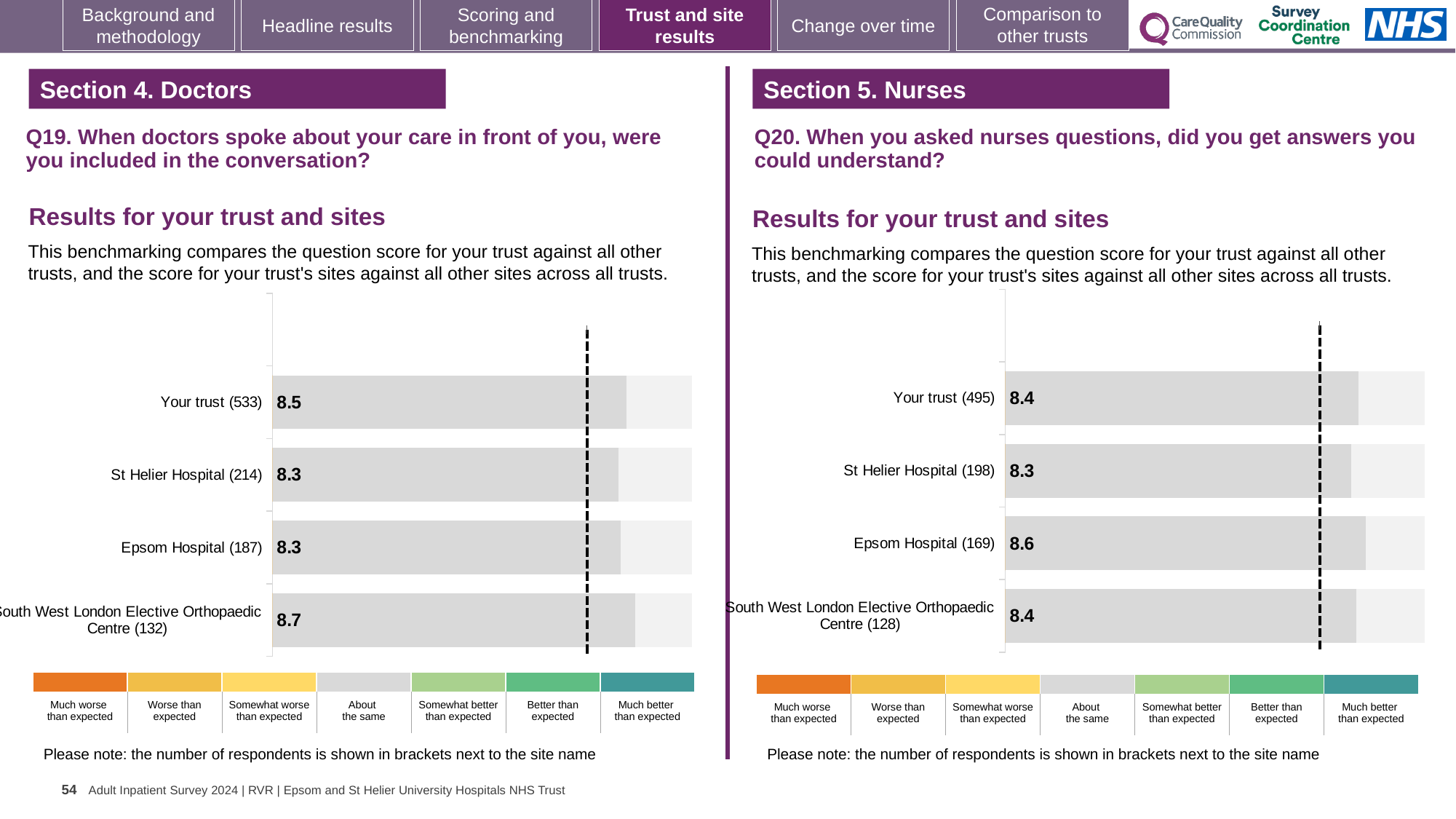
On the Q20 chart (right), how many respondents are shown in brackets for Your trust? 495 On the Q20 chart (right), what is the difference between the scores for Epsom Hospital and St Helier Hospital? 0.3 On the Q20 chart (right), what is the score for St Helier Hospital (198)? 8.3 On the Q19 chart (left), which site or trust has the highest score? South West London Elective Orthopaedic Centre (132) On the Q20 chart (right), which site or trust has the lowest score? St Helier Hospital (198) On the Q20 chart (right), which has the higher score, Epsom Hospital or Your trust? Epsom Hospital On the Q19 chart (left), what is the difference between the scores for South West London Elective Orthopaedic Centre and St Helier Hospital? 0.4 On the Q19 chart (left), what is the score for Your trust (533)? 8.5 What type of chart is used on the Q19 chart (left)? Bar chart On the Q20 chart (right), what is the score for Epsom Hospital (169)? 8.6 On the Q19 chart (left), how many bars are plotted? 4 On the Q19 chart (left), what is the score for South West London Elective Orthopaedic Centre (132)? 8.7